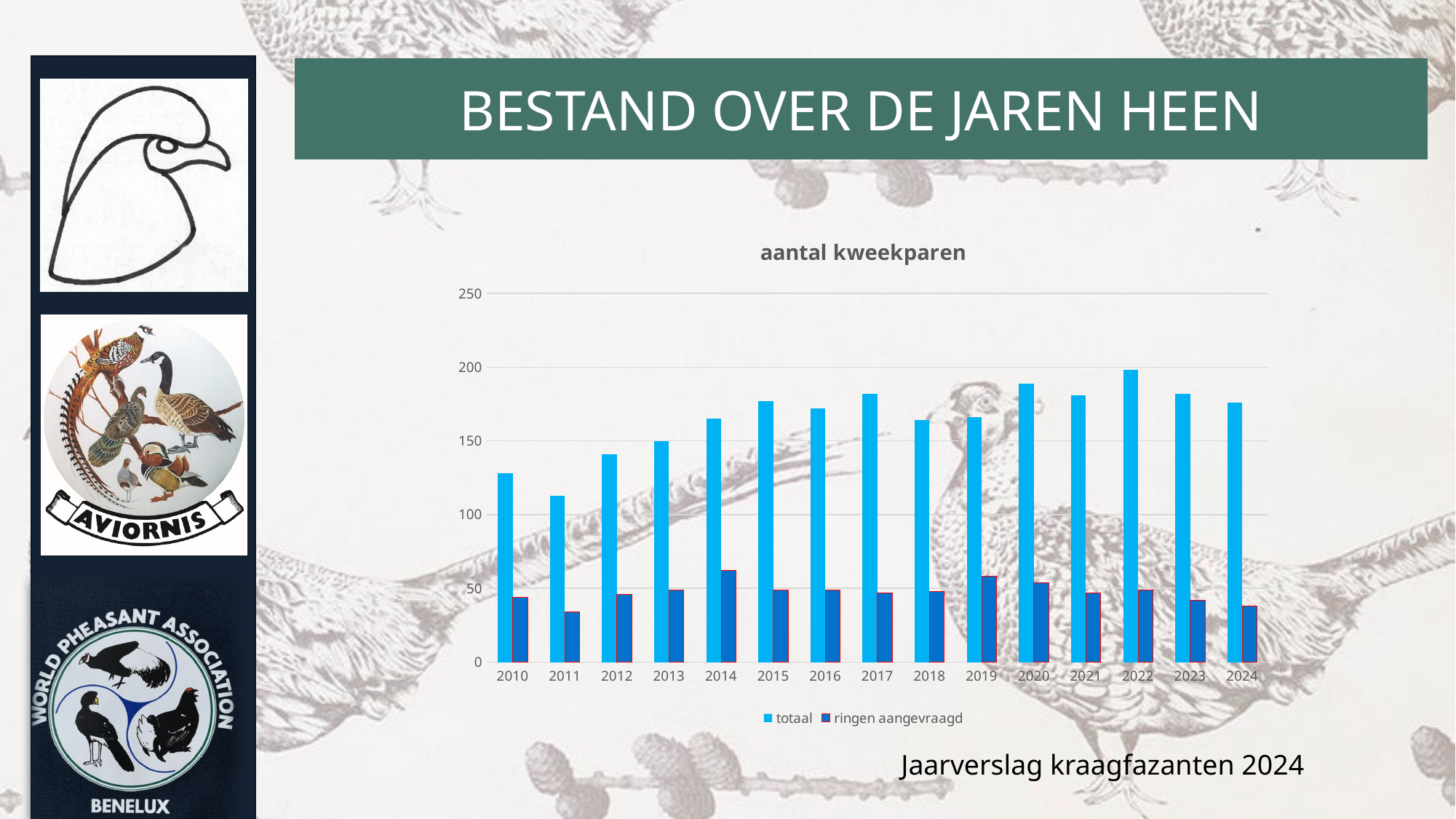
Is the value for totaal in 2010 greater or less than 100? greater What kind of chart is shown on the slide? bar chart How many years are shown on the x axis? 15 Which year has the lowest value for ringen aangevraagd? 2011 How many series does the legend list? 2 Which year has the highest value for totaal? 2022 Is the value for ringen aangevraagd in 2011 greater or less than 50? less Which year has the lowest value for totaal? 2011 Is the value for totaal in 2020 greater or less than 200? less Which year has the highest value for ringen aangevraagd? 2014 What is the title of the chart? aantal kweekparen